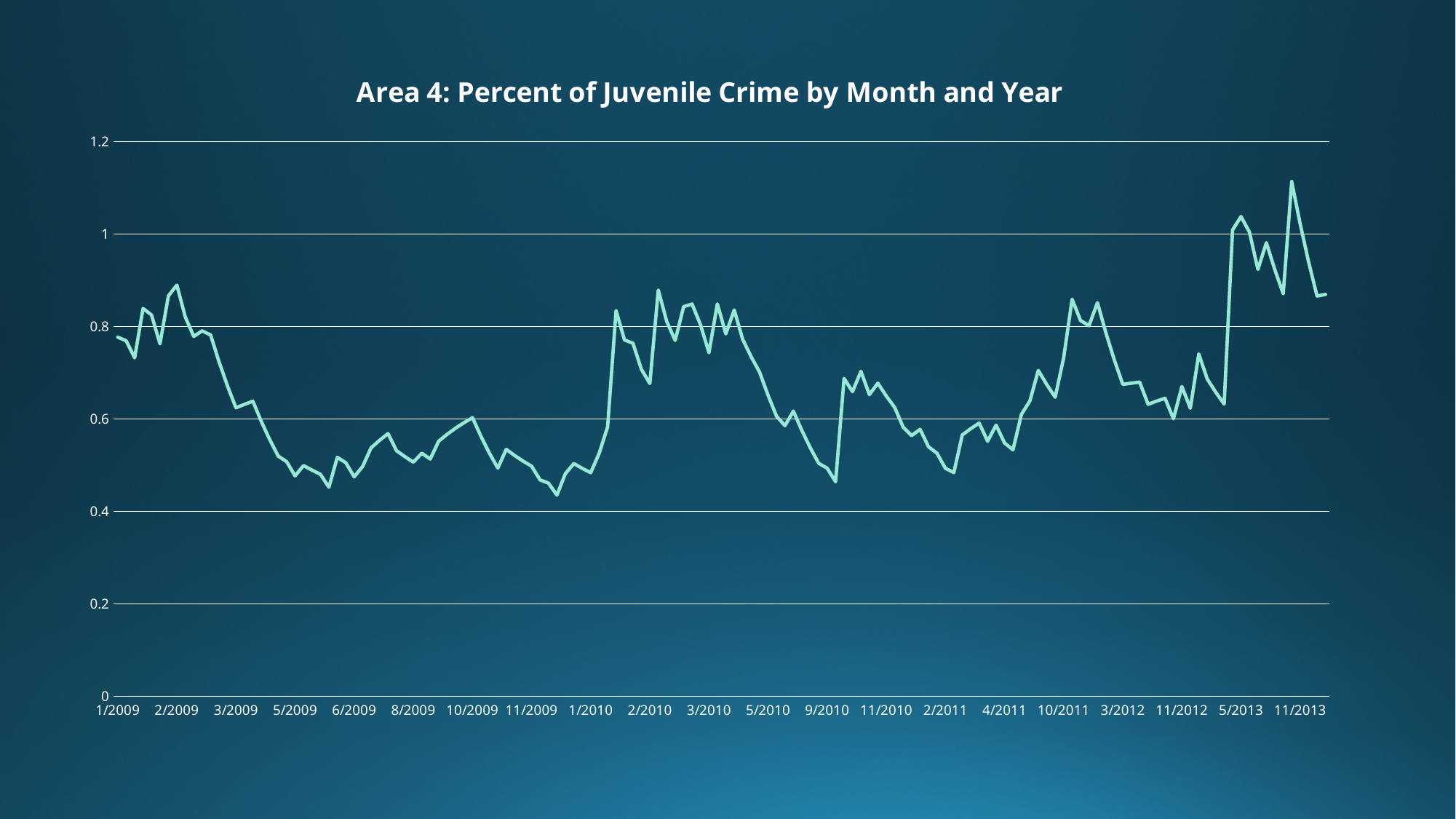
Between 1/2009 and 5/2009, does the line generally rise or fall? fall How many lines (series) are plotted on the chart? 1 Is the value for 1/2009 greater or less than 0.6? greater Is the highest point on the line greater or less than 1? greater What kind of chart is shown on the slide? line chart Is the value for 5/2009 greater or less than 0.6? less What is the title of the chart? Area 4: Percent of Juvenile Crime by Month and Year Which has the larger value, 5/2013 or 5/2009? 5/2013 What is the highest value shown on the y axis? 1.2